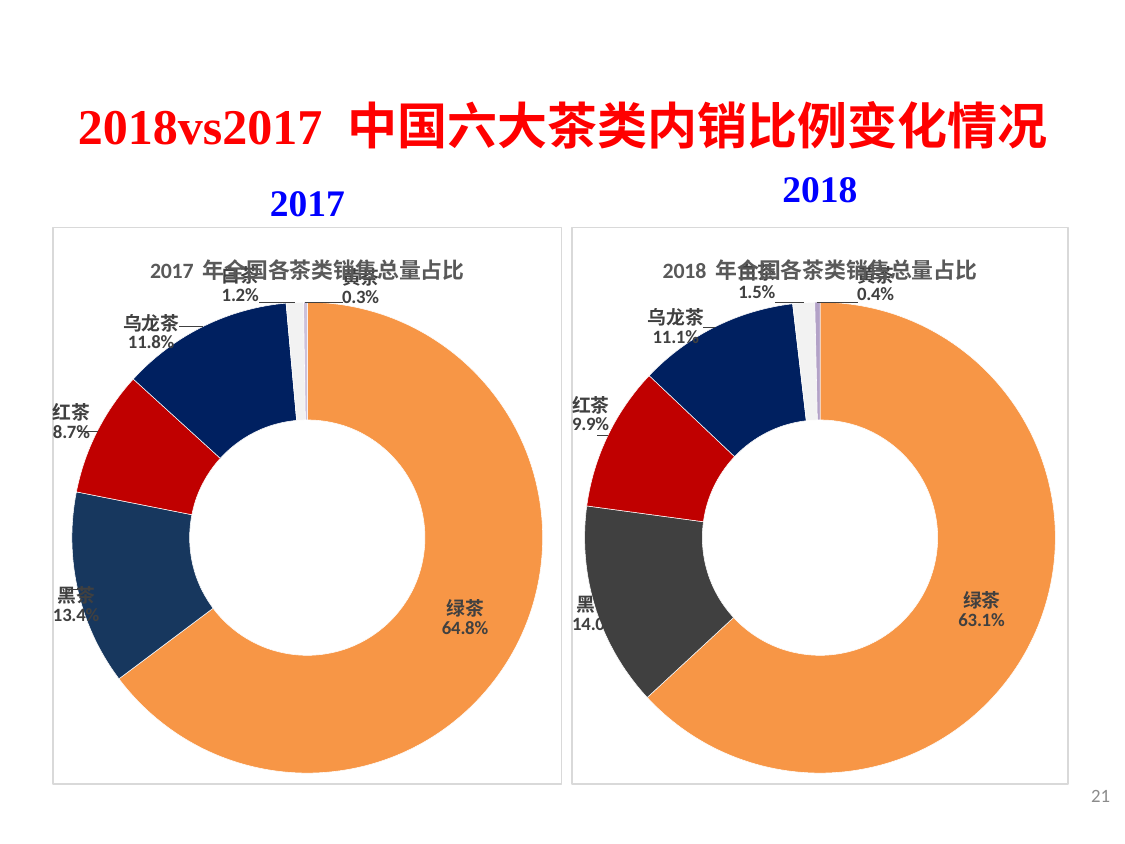
In the 2017 chart, which tea category has the smallest share? 黄茶 In the 2017 chart, what share does 绿茶 have? 64.8% Which is larger: the 红茶 share in 2017 or in 2018? 2018 In the 2018 chart, what is the value for 红茶? 9.9% How many tea categories are shown in the 2018 chart? 6 In the 2017 chart, which tea category has the largest share? 绿茶 What is the difference between the 绿茶 share in 2017 and in 2018? 1.7% In the 2018 chart, what is the value for 白茶? 1.5% In the 2018 chart, what share does 绿茶 have? 63.1% In the 2017 chart, what is the value for 乌龙茶? 11.8% In the 2017 chart, what is the value for 黑茶? 13.4% What kind of chart is used on this slide? Donut (pie) chart